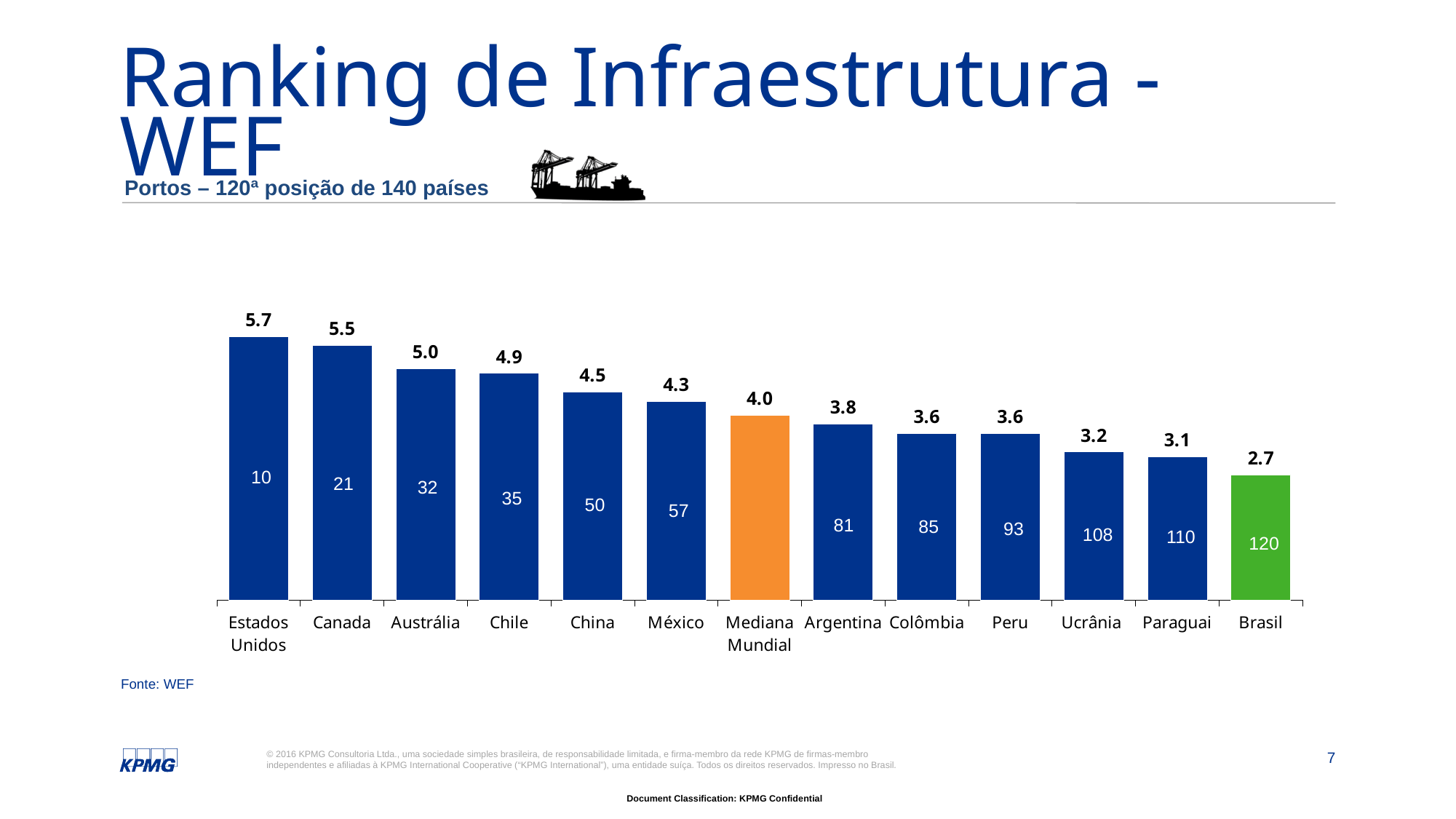
Which category has the highest score? Estados Unidos Which bar is coloured green? Brasil What score is shown above the bar for Mediana Mundial? 4.0 What ranking position is printed inside the bar for Chile? 35 What is the difference between the ranking positions of Paraguai and Brasil? 10 What kind of chart is shown on the slide? Bar chart How many categories are shown on the x axis? 13 What is the difference between the scores of Estados Unidos and Brasil? 3.0 Which category has the lowest score? Brasil What score is shown above the bar for Brasil? 2.7 What ranking position is printed inside the bar for Ucrânia? 108 Which has a higher score, Canada or Austrália? Canada